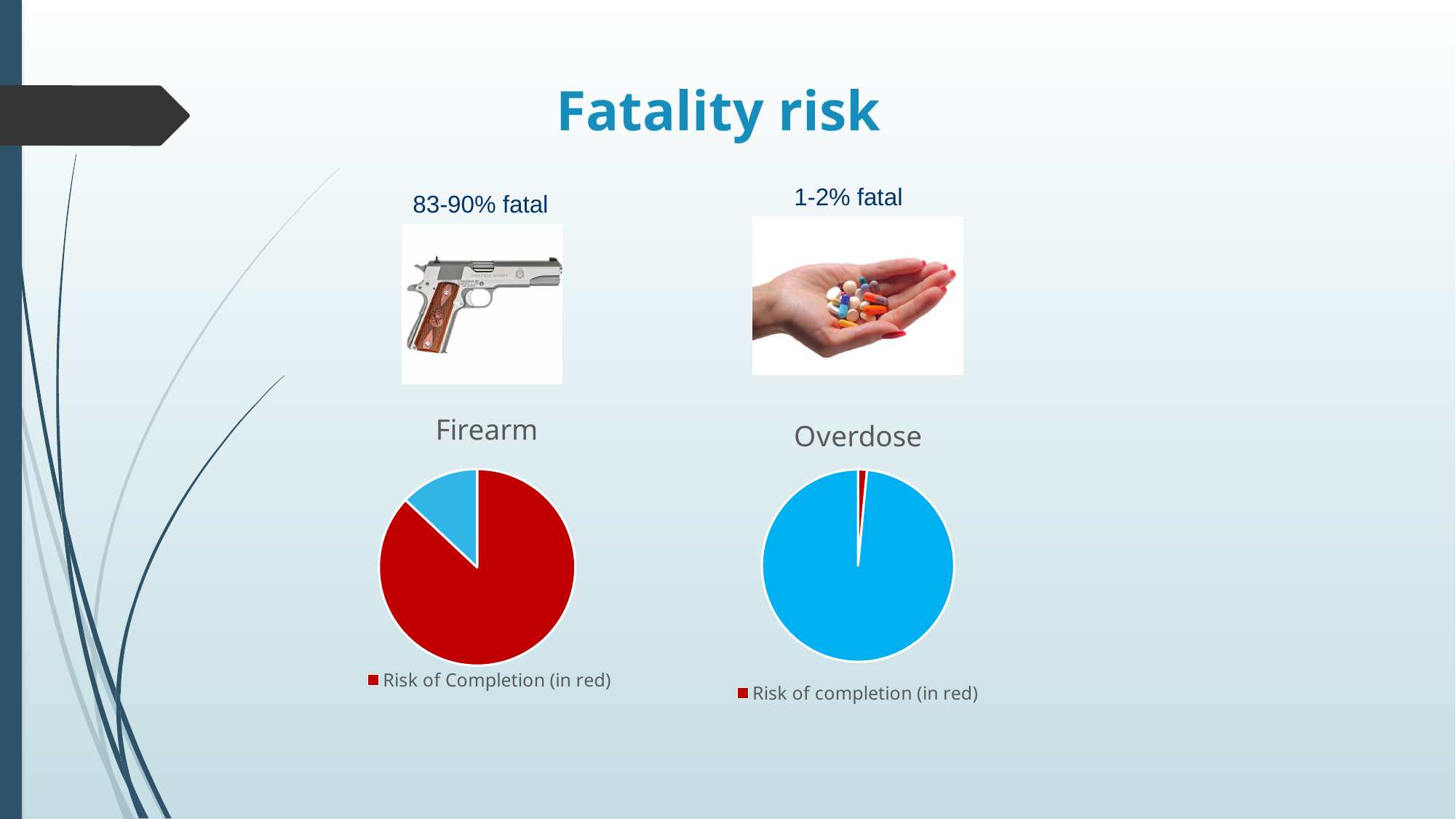
In the Firearm pie chart, which slice is larger, the red one or the blue one? the red one What kind of chart is the Firearm chart? pie chart In the Overdose pie chart, which slice is larger, the red one or the blue one? the blue one Which chart has the larger red slice, Firearm or Overdose? Firearm What is the legend entry shown under the Firearm pie chart? Risk of Completion (in red) How many entries does the legend of the Overdose chart list? 1 What is the title of the pie chart on the right of the slide? Overdose How many slices does the Overdose pie chart have? 2 What kind of chart is the Overdose chart? pie chart How many entries does the legend of the Firearm chart list? 1 How many slices does the Firearm pie chart have? 2